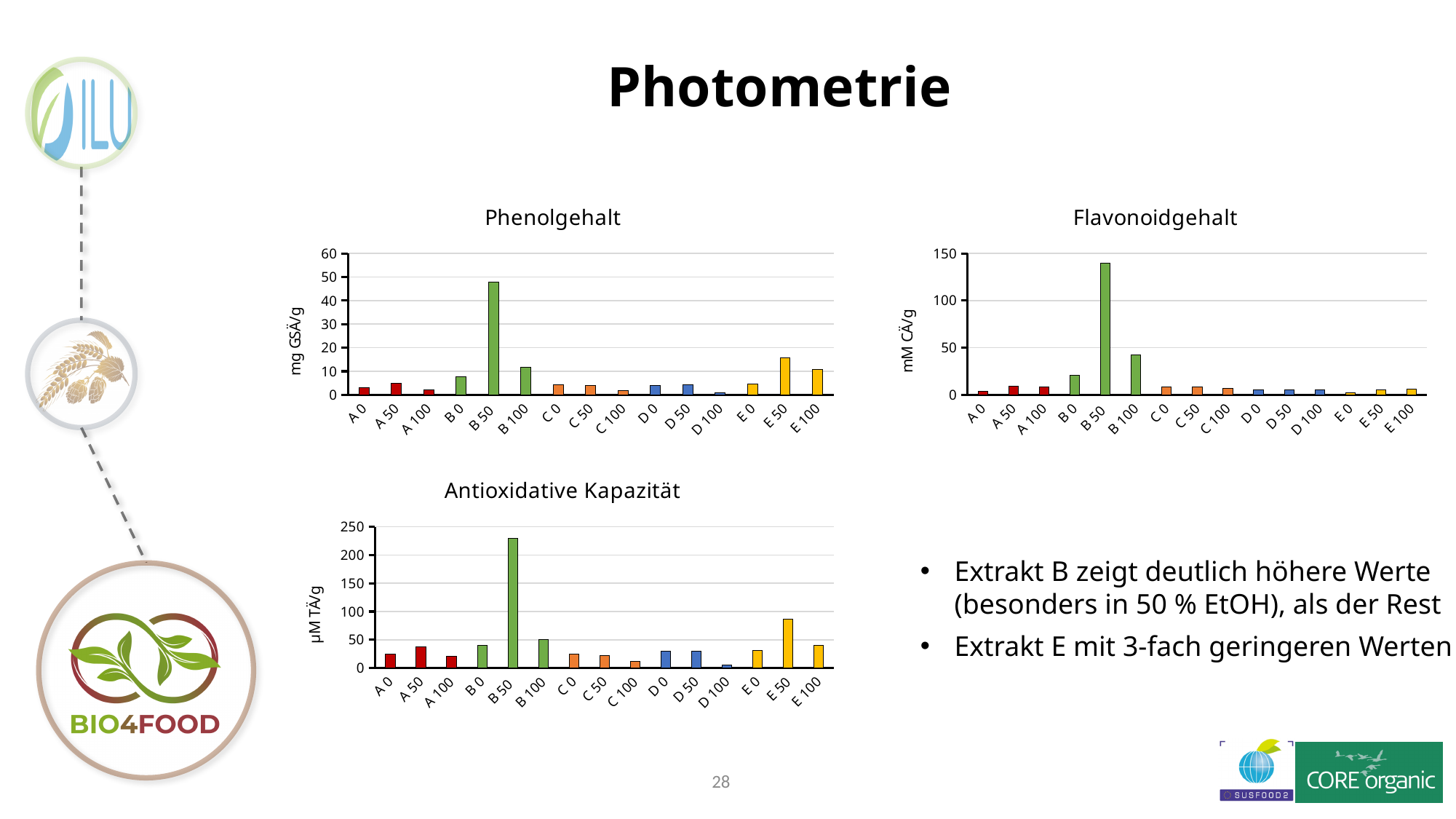
In the Phenolgehalt chart, which is larger, the value for E 50 or the value for B 100? E 50 In the Antioxidative Kapazität chart, which is larger, the value for E 50 or the value for B 100? E 50 What kind of chart is the Phenolgehalt chart? bar chart In the Phenolgehalt chart, is the value for B 50 greater or less than 40? greater In the Flavonoidgehalt chart, is the value for B 100 greater or less than 50? less In the Flavonoidgehalt chart, which category has the highest value? B 50 In the Antioxidative Kapazität chart, is the value for B 50 greater or less than 200? greater What is the title of the chart in the lower left of the slide? Antioxidative Kapazität In the Phenolgehalt chart, which category has the highest value? B 50 What is the y-axis label of the Flavonoidgehalt chart? mM CÄ/g How many categories are shown on the x axis of the Antioxidative Kapazität chart? 15 In the Antioxidative Kapazität chart, which category has the highest value? B 50